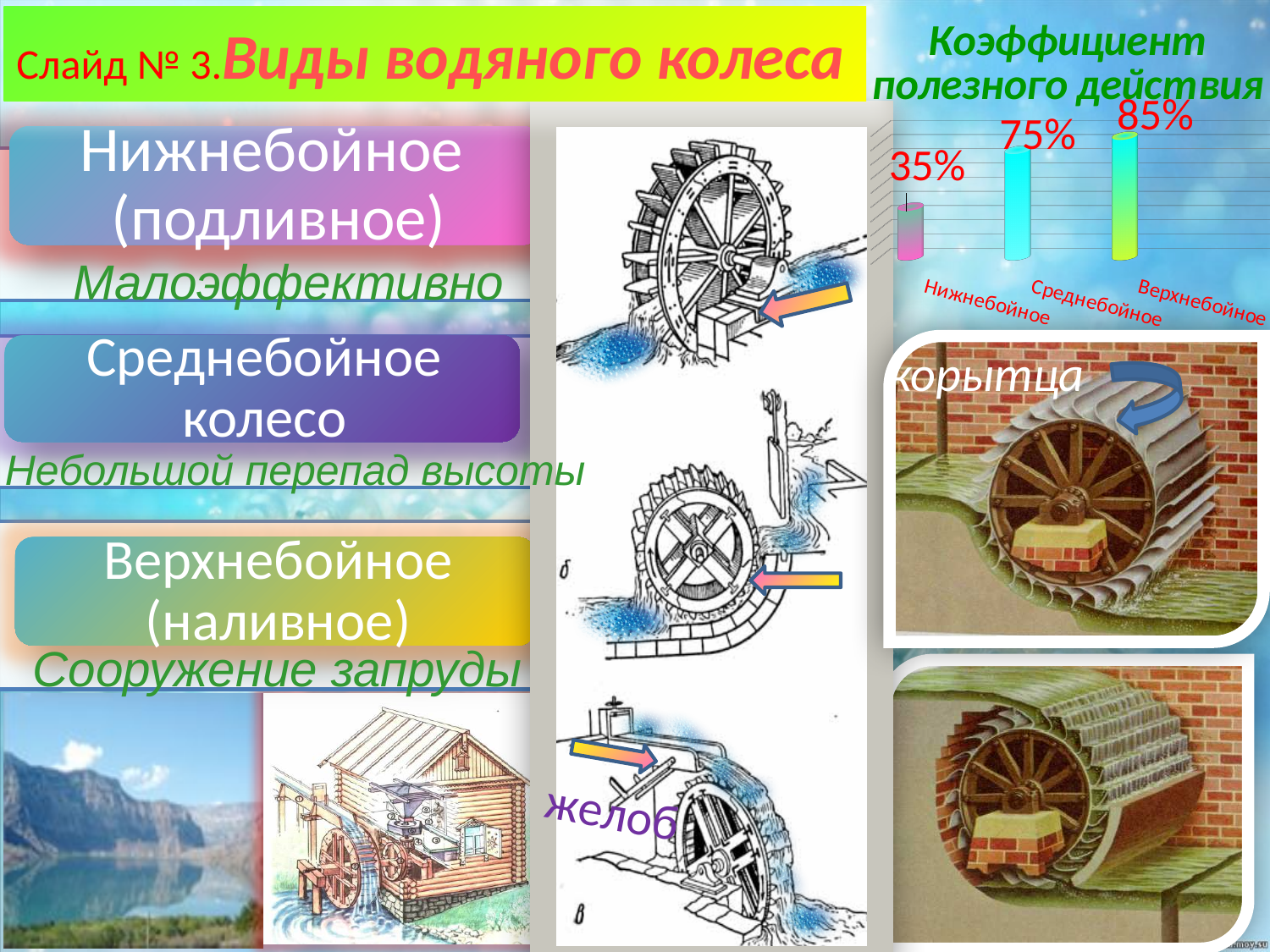
Which wheel type has the highest efficiency in the chart? Верхнебойное Which has a higher efficiency, Среднебойное or Нижнебойное? Среднебойное What is the efficiency value shown for Нижнебойное in the chart? 35% What kind of chart is used to show the efficiency values? Bar chart How many wheel types are shown in the chart? 3 What is the efficiency value shown for Верхнебойное in the chart? 85% What is the title of the chart on the slide? Коэффициент полезного действия What is the difference between the efficiency of Верхнебойное and Нижнебойное? 50% What is the difference between the efficiency of Верхнебойное and Среднебойное? 10% Which wheel type has the lowest efficiency in the chart? Нижнебойное What is the difference between the efficiency of Среднебойное and Нижнебойное? 40% What is the efficiency value shown for Среднебойное in the chart? 75%